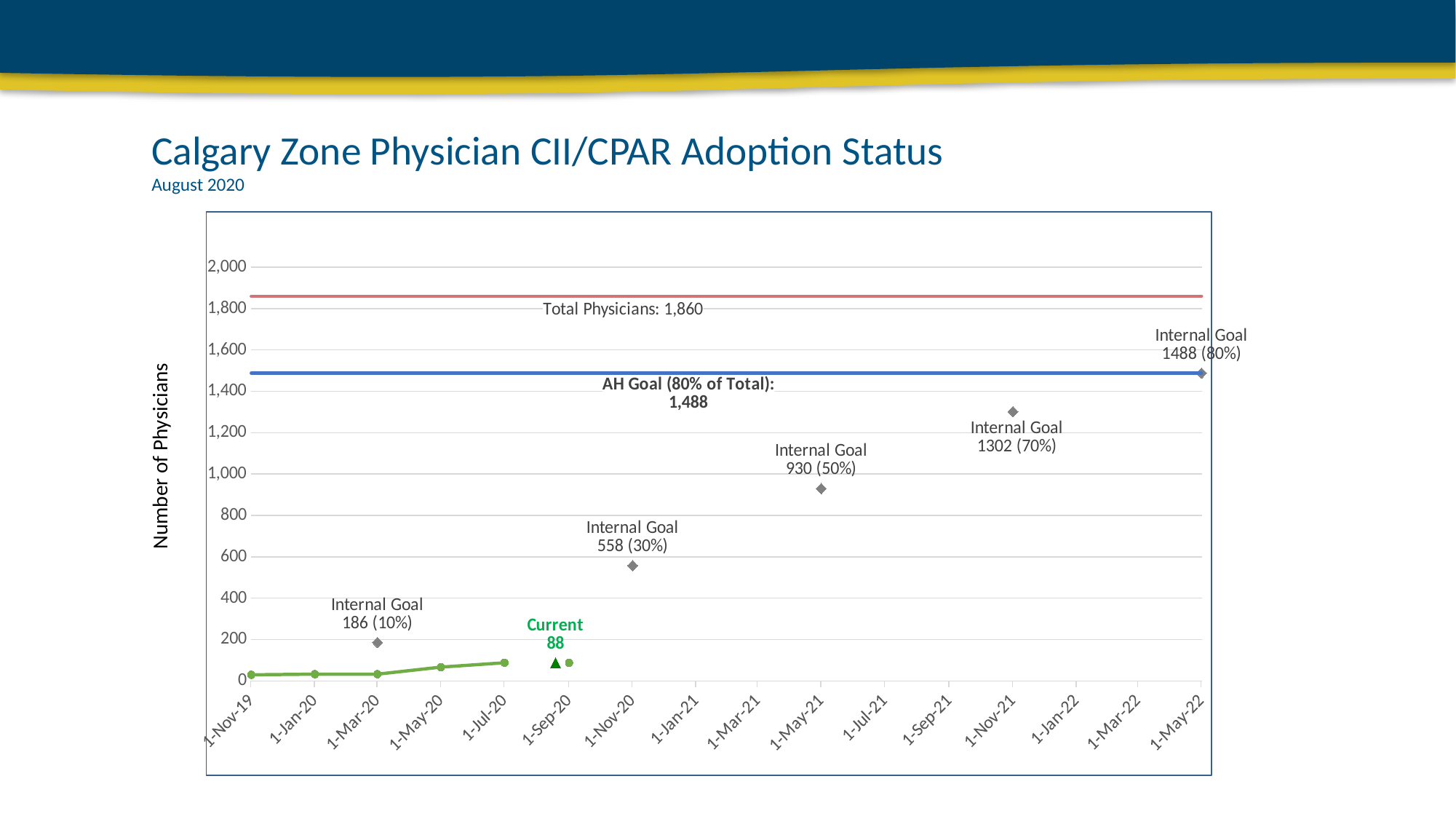
What is the difference between the AH Goal (1,488) and the Current value (88)? 1,400 What is the Internal Goal labelled near 1-Nov-20? 558 (30%) What is the Internal Goal labelled near 1-May-21? 930 (50%) How many Internal Goal markers are plotted on the chart? 5 What is the Current value labelled on the chart? 88 What is the Internal Goal labelled near 1-Nov-21? 1302 (70%) What is the Internal Goal labelled near 1-Mar-20? 186 (10%) What is the label of the vertical axis? Number of Physicians What is the AH Goal (80% of Total) value shown on the chart? 1,488 What is the difference between Total Physicians (1,860) and the AH Goal (1,488)? 372 What is the Total Physicians value shown on the chart? 1,860 Does the green adoption line rise or fall from 1-Nov-19 to 1-Jul-20? rise